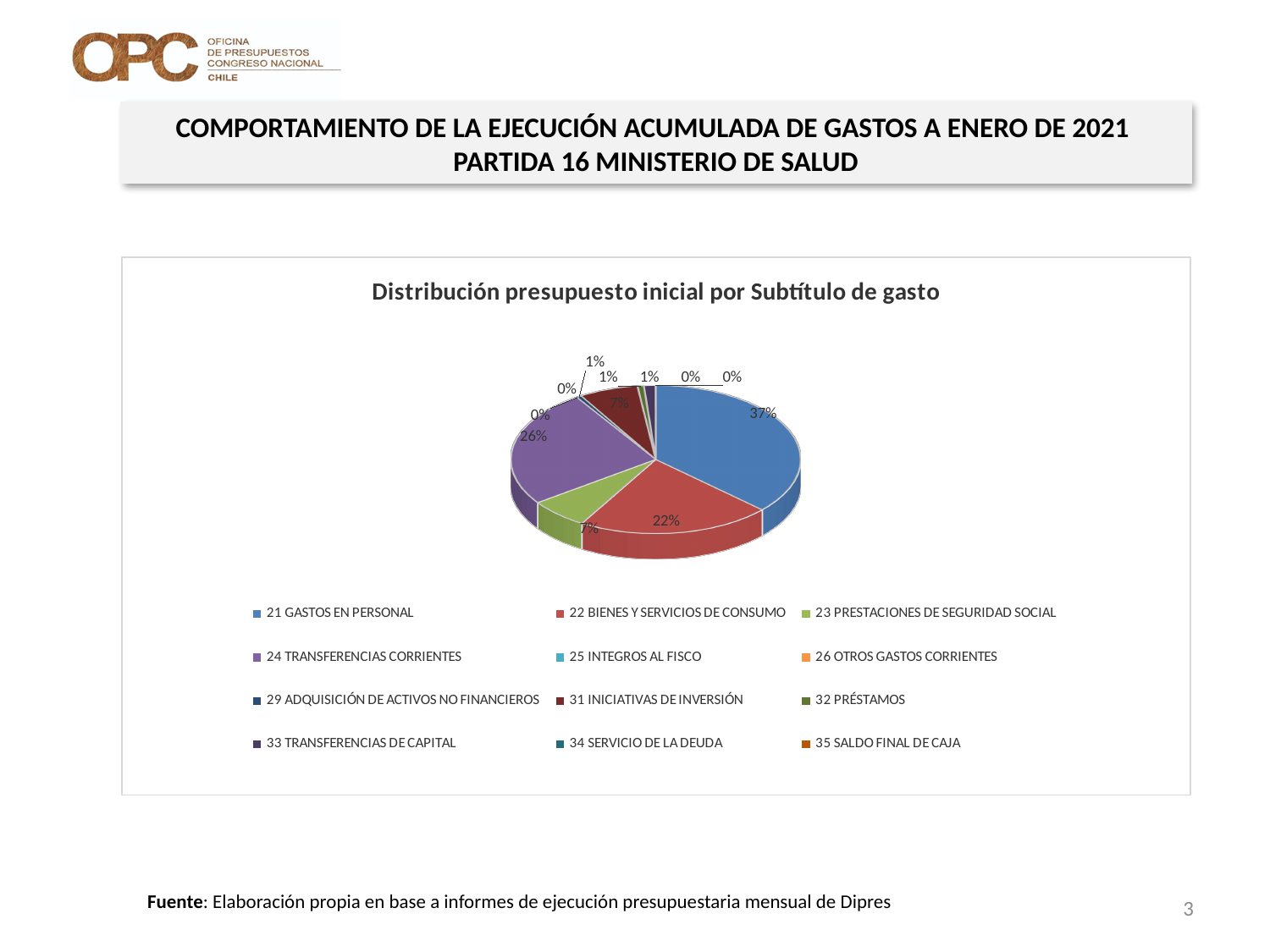
What share of the pie does 21 GASTOS EN PERSONAL represent? 37% By how many percentage points does the share of 22 BIENES Y SERVICIOS DE CONSUMO exceed that of 23 PRESTACIONES DE SEGURIDAD SOCIAL? 15 percentage points How many categories does the legend list? 12 Which is larger, the slice for 22 BIENES Y SERVICIOS DE CONSUMO or the slice for 23 PRESTACIONES DE SEGURIDAD SOCIAL? 22 BIENES Y SERVICIOS DE CONSUMO By how many percentage points does the share of 21 GASTOS EN PERSONAL exceed that of 24 TRANSFERENCIAS CORRIENTES? 11 percentage points What share of the pie does 24 TRANSFERENCIAS CORRIENTES represent? 26% What kind of chart is shown on the slide? Pie chart Which category has the largest slice of the pie? 21 GASTOS EN PERSONAL What share of the pie does 22 BIENES Y SERVICIOS DE CONSUMO represent? 22% Which is larger, the slice for 21 GASTOS EN PERSONAL or the slice for 24 TRANSFERENCIAS CORRIENTES? 21 GASTOS EN PERSONAL What is the title of the chart? Distribución presupuesto inicial por Subtítulo de gasto